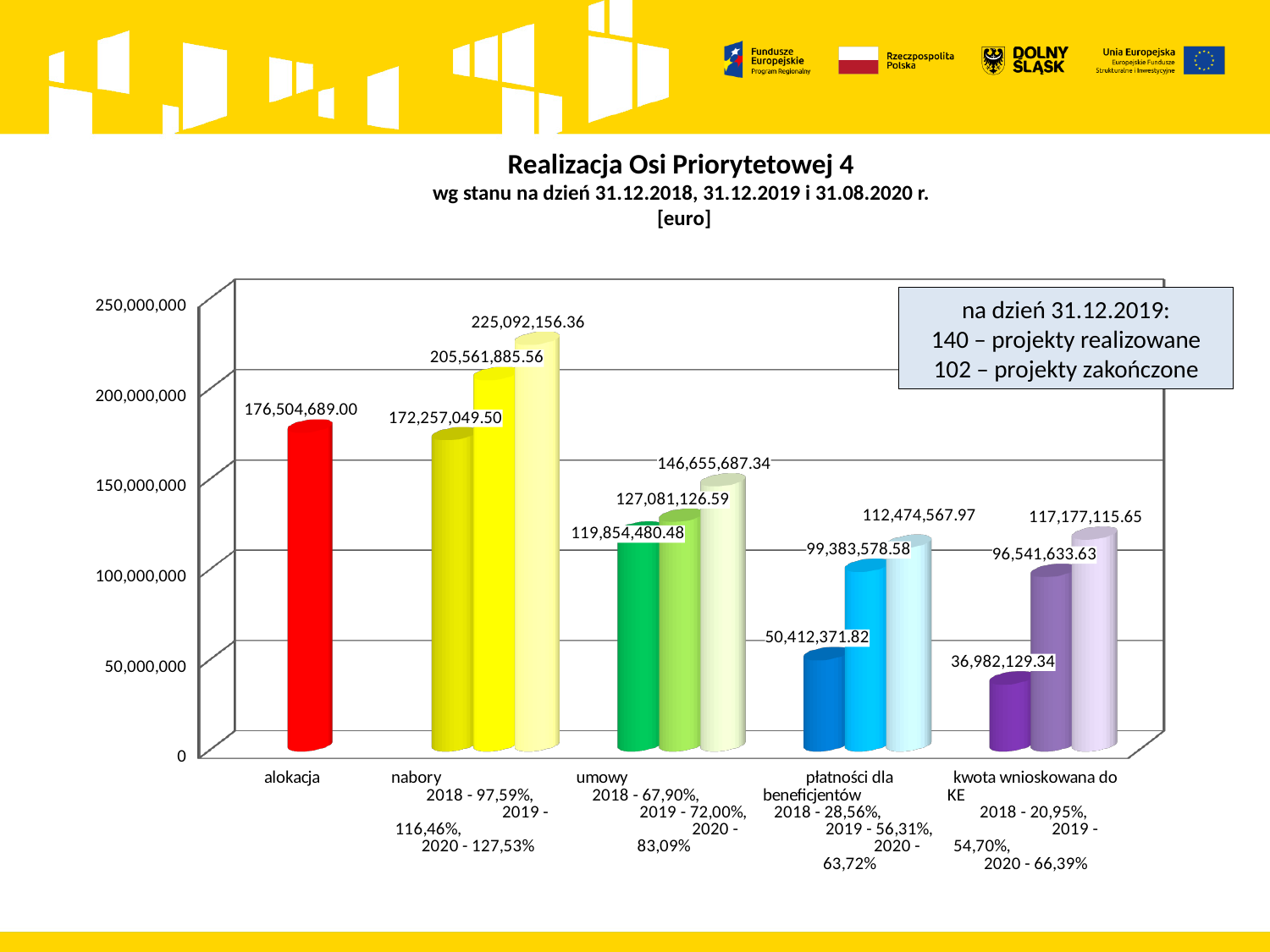
What is the value of the tallest bar in the nabory group (the 2020 bar)? 225,092,156.36 Is the value of the alokacja bar greater or less than 150,000,000? greater What type of chart is shown on the slide? bar chart What is the value of the alokacja bar? 176,504,689.00 What is the value of the middle (2019) bar in the umowy group? 127,081,126.59 Which bar on the chart has the lowest value? kwota wnioskowana do KE 2018 (36,982,129.34) What is the value of the shortest bar in the płatności dla beneficjentów group (the 2018 bar)? 50,412,371.82 Which bar on the chart has the highest value? nabory 2020 (225,092,156.36) What is the difference between the highest and lowest bars in the nabory group? 52,835,106.86 How many category groups are shown on the x axis? 5 Do the bars in the płatności dla beneficjentów group rise or fall from left to right? rise Which is larger: the alokacja bar or the first (2018) bar in the nabory group? alokacja